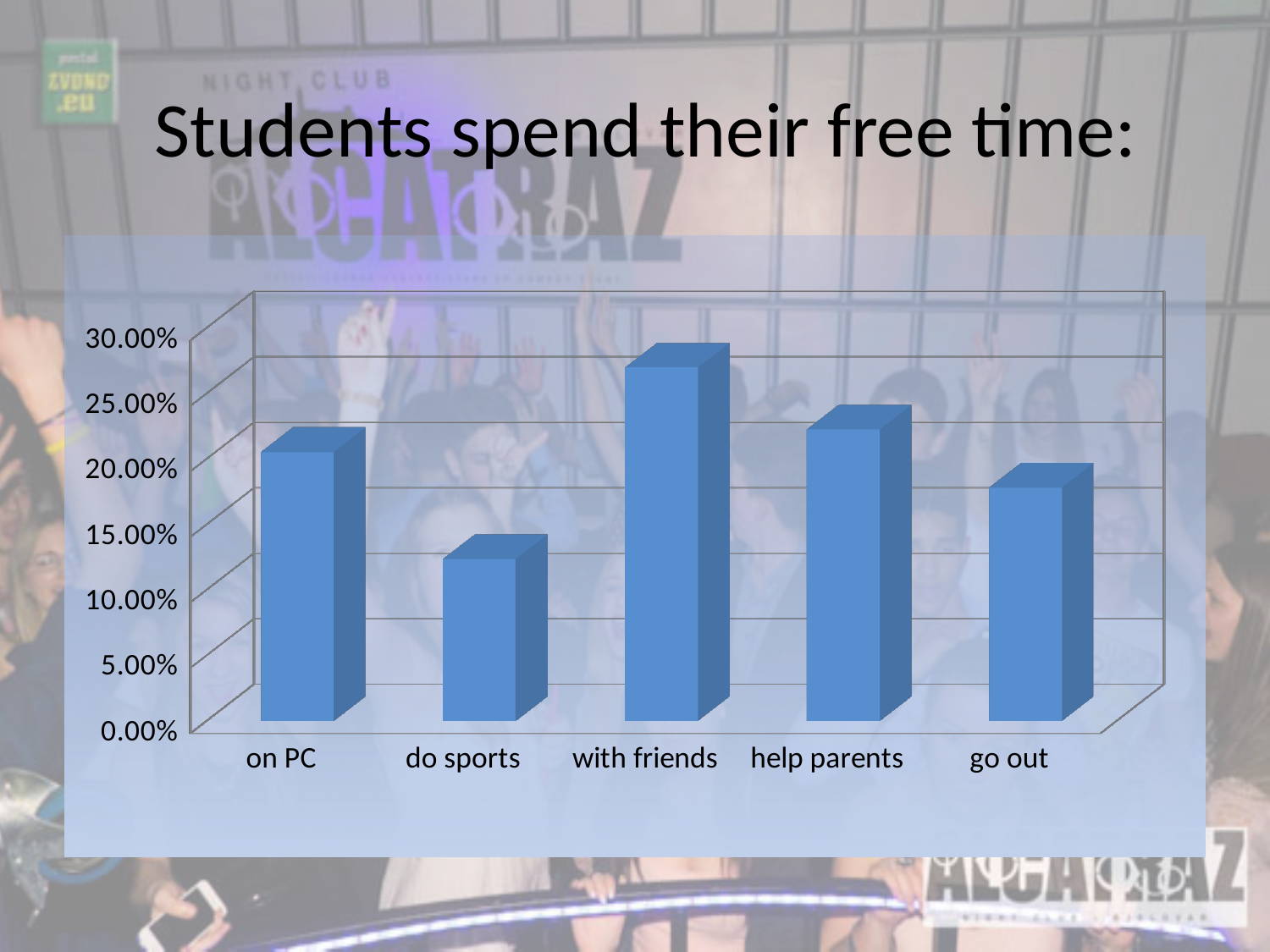
Which category has the highest value in the chart? with friends What kind of chart is shown on the slide? bar chart Which is larger, the value for on PC or the value for do sports? on PC Is the value for go out greater or less than 20.00%? less How many categories are shown on the x axis of the chart? 5 Is the value for do sports greater or less than 15.00%? less Which category has the lowest value in the chart? do sports What is the title of the slide containing the chart? Students spend their free time: Is the value for on PC greater or less than 15.00%? greater Which is larger, the value for help parents or the value for go out? help parents